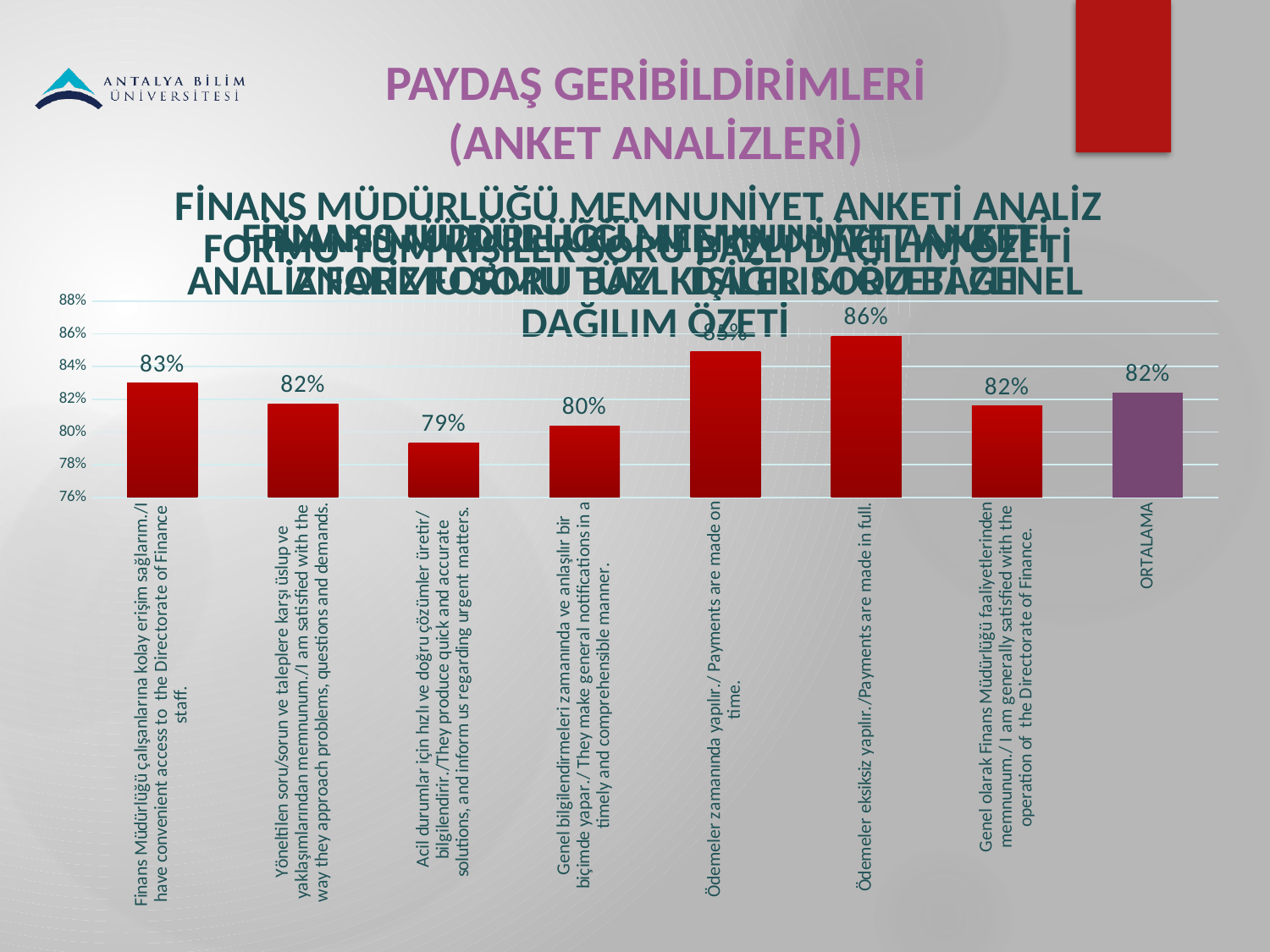
Which is larger: the value for "I have convenient access to the Directorate of Finance staff." or the value for "They make general notifications in a timely and comprehensible manner."? I have convenient access to the Directorate of Finance staff. What is the difference between the highest value (Payments are made in full) and the lowest value (They produce quick and accurate solutions)? 7 percentage points Is the value for "Ödemeler zamanında yapılır./Payments are made on time." greater or less than 84%? greater Which category has the lowest value? Acil durumlar için hızlı ve doğru çözümler üretir/bilgilendirir./They produce quick and accurate solutions, and inform us regarding urgent matters. What is the value for the category "They produce quick and accurate solutions, and inform us regarding urgent matters."? 79% What is the value for the category "They make general notifications in a timely and comprehensible manner."? 80% What is the value for the category "I have convenient access to the Directorate of Finance staff."? 83% What is the value shown for ORTALAMA? 82% Which category has the highest value? Ödemeler eksiksiz yapılır./Payments are made in full. What is the value for the category "Ödemeler eksiksiz yapılır./Payments are made in full."? 86% How many bars are plotted in the chart? 8 What kind of chart is shown on the slide? bar chart